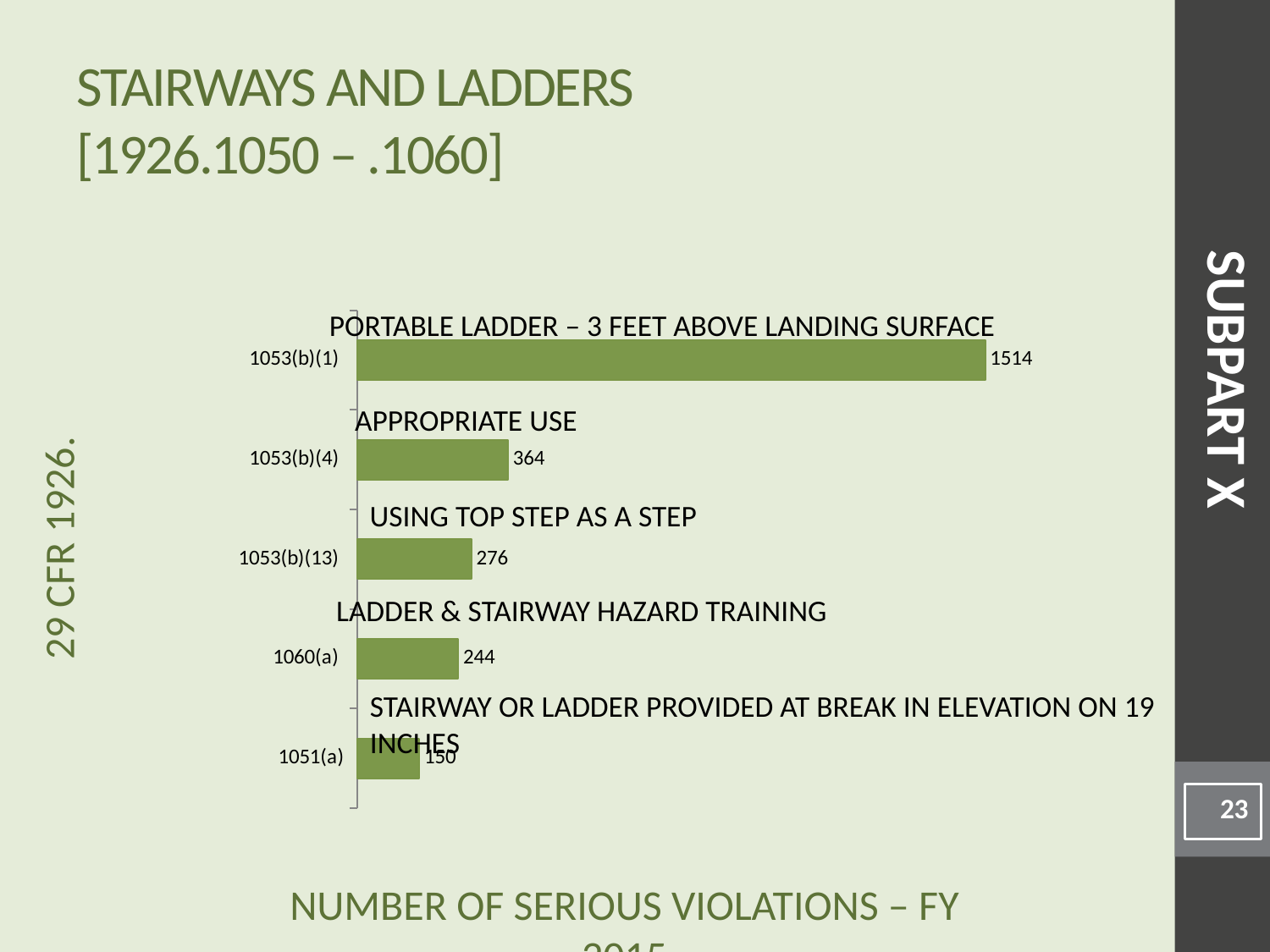
How many standards are shown in the chart? 5 Which standard has the highest number of serious violations? 1053(b)(1) What kind of chart is shown on the slide? Bar chart What is the difference in serious violations between 1053(b)(13) and 1060(a)? 32 What is the number of serious violations for 1051(a)? 150 What is the difference in serious violations between 1053(b)(1) and 1053(b)(4)? 1150 What is the number of serious violations for 1053(b)(1)? 1514 Which standard has the lowest number of serious violations? 1051(a) What is the number of serious violations for 1060(a)? 244 What is the number of serious violations for 1053(b)(4)? 364 What is the number of serious violations for 1053(b)(13)? 276 Which has more serious violations, 1053(b)(4) or 1060(a)? 1053(b)(4)